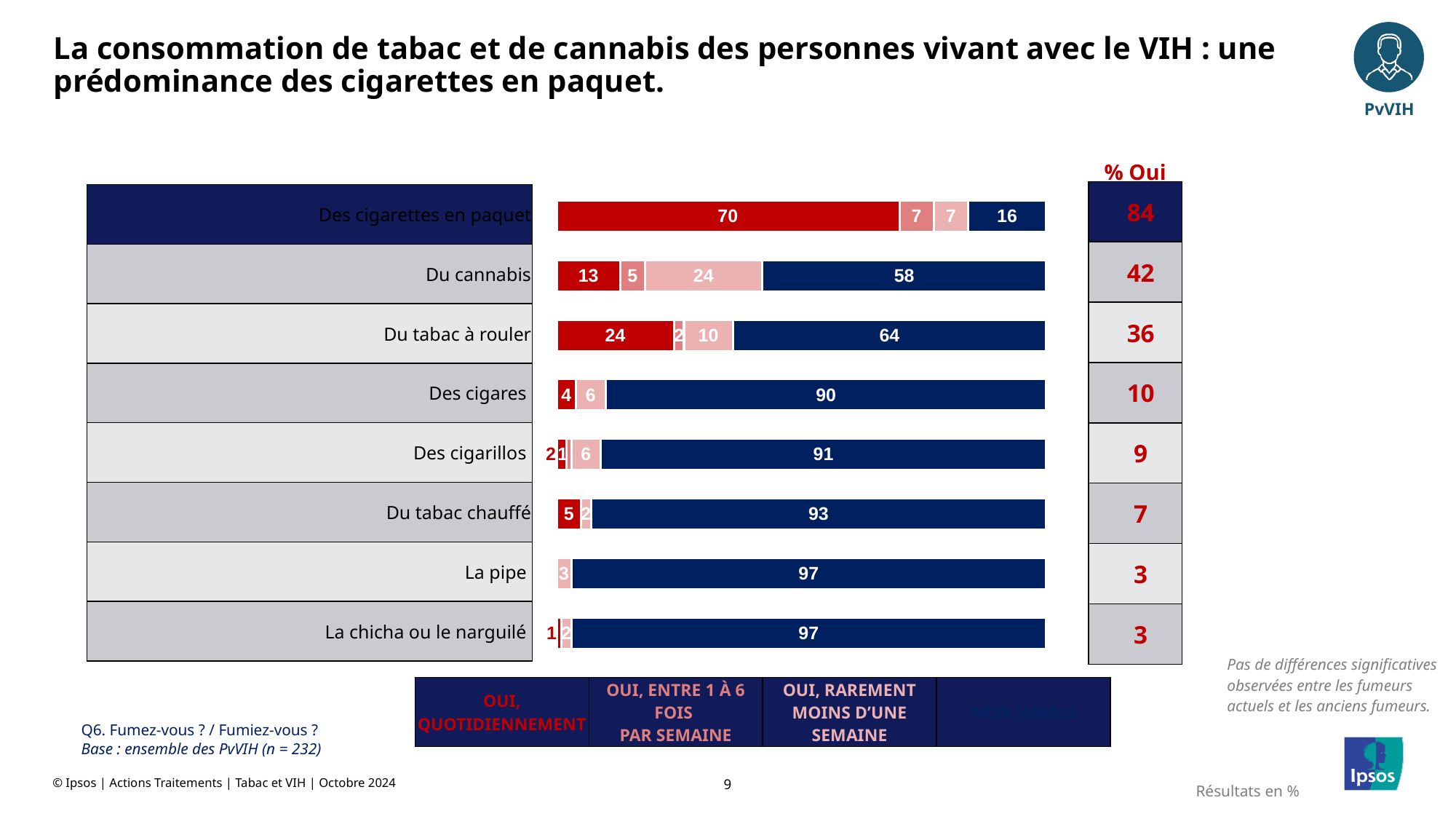
What is the difference between the '% Oui' values for 'Des cigarettes en paquet' and 'Du cannabis'? 42 Which category has the highest '% Oui' value? Des cigarettes en paquet What is the '% Oui' value for 'Du cannabis'? 42 How many series does the legend list? 4 Which is larger: the 'Oui, quotidiennement' value for 'Du tabac à rouler' or for 'Du cannabis'? Du tabac à rouler What is the total of the three 'Oui' segments for 'Du cannabis'? 42 What is the base (n) stated for the chart? n = 232 Which category has the lowest 'Oui, quotidiennement' value among those with a printed value? La chicha ou le narguilé What is the 'Oui, rarement moins d'une semaine' value for 'Du tabac à rouler'? 10 How many categories are shown in the chart? 8 What is the 'Oui, quotidiennement' value for 'Des cigarettes en paquet'? 70 What kind of chart is shown on the slide? Stacked bar chart